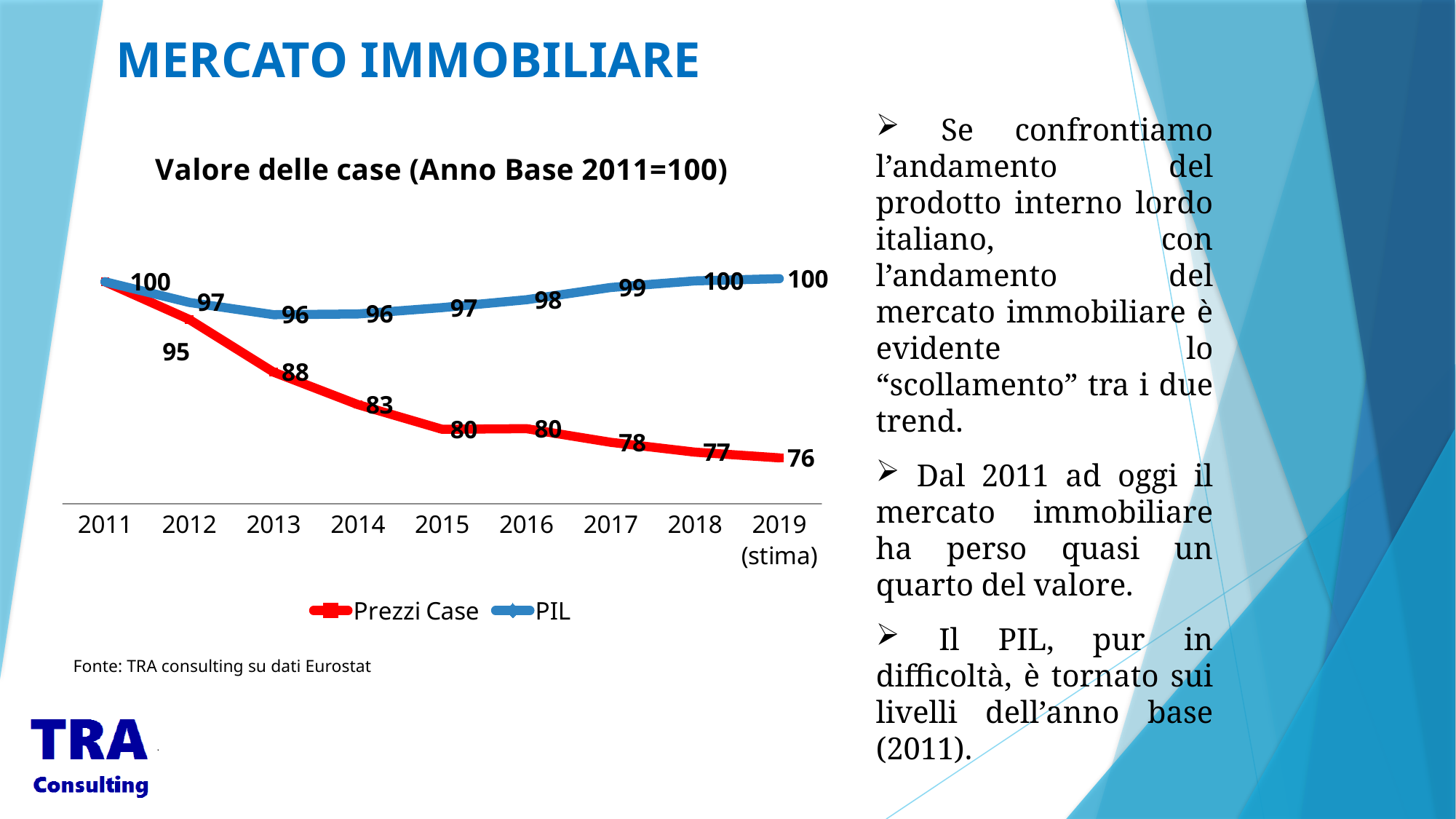
In which year is the Prezzi Case series lowest? 2019 (stima) What is the value of Prezzi Case in 2019 (stima)? 76 How many series does the legend list? 2 Which series has the higher value in 2016, Prezzi Case or PIL? PIL Does the Prezzi Case series rise or fall from 2011 to 2019 (stima)? Fall What is the value of PIL in 2013? 96 What is the title of the chart? Valore delle case (Anno Base 2011=100) What is the difference between Prezzi Case in 2012 and in 2013? 7 What is the difference between PIL and Prezzi Case in 2019 (stima)? 24 What type of chart is shown on the slide? Line chart How many years are shown on the x axis? 9 What is the value of Prezzi Case in 2014? 83